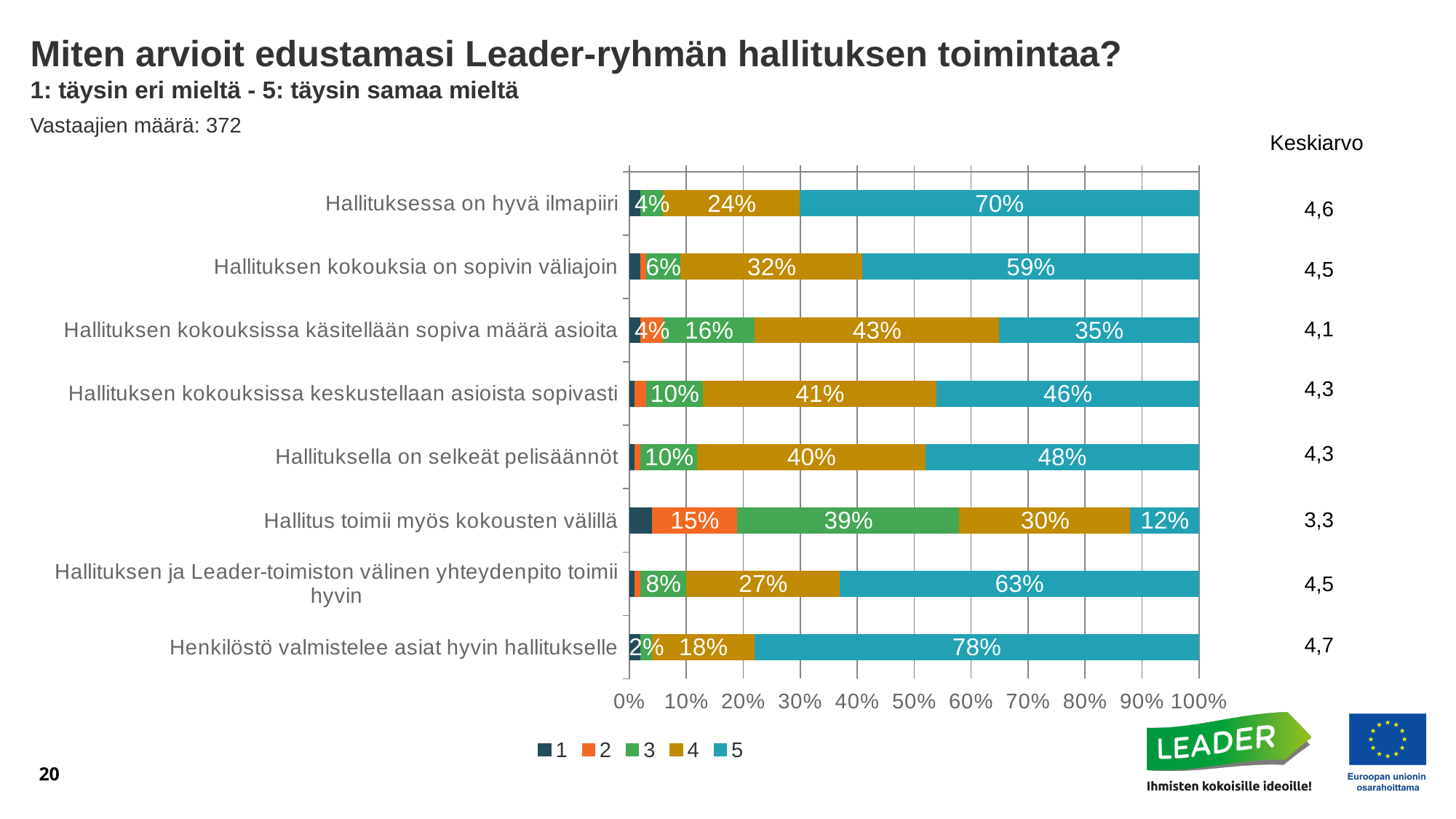
Which statement has a larger share of rating 4 responses: "Hallituksen kokouksia on sopivin väliajoin" or "Hallituksen ja Leader-toimiston välinen yhteydenpito toimii hyvin"? Hallituksen kokouksia on sopivin väliajoin Which statement has the lowest share of rating 5 responses? Hallitus toimii myös kokousten välillä What percentage of respondents gave a rating of 5 for "Hallituksessa on hyvä ilmapiiri"? 70% What percentage of respondents gave a rating of 3 for "Hallitus toimii myös kokousten välillä"? 39% How many respondents (Vastaajien määrä) does the slide report? 372 What is the difference in percentage points between the rating 5 share for "Henkilöstö valmistelee asiat hyvin hallitukselle" and for "Hallituksessa on hyvä ilmapiiri"? 8 percentage points What is the Keskiarvo (mean) shown for "Hallitus toimii myös kokousten välillä"? 3,3 What kind of chart is shown on the slide? Stacked bar chart Which statement has the highest share of rating 5 responses? Henkilöstö valmistelee asiat hyvin hallitukselle How many series does the legend list? 5 What percentage of respondents gave a rating of 4 for "Hallituksen kokouksissa käsitellään sopiva määrä asioita"? 43% How many statements (categories) are shown in the chart? 8